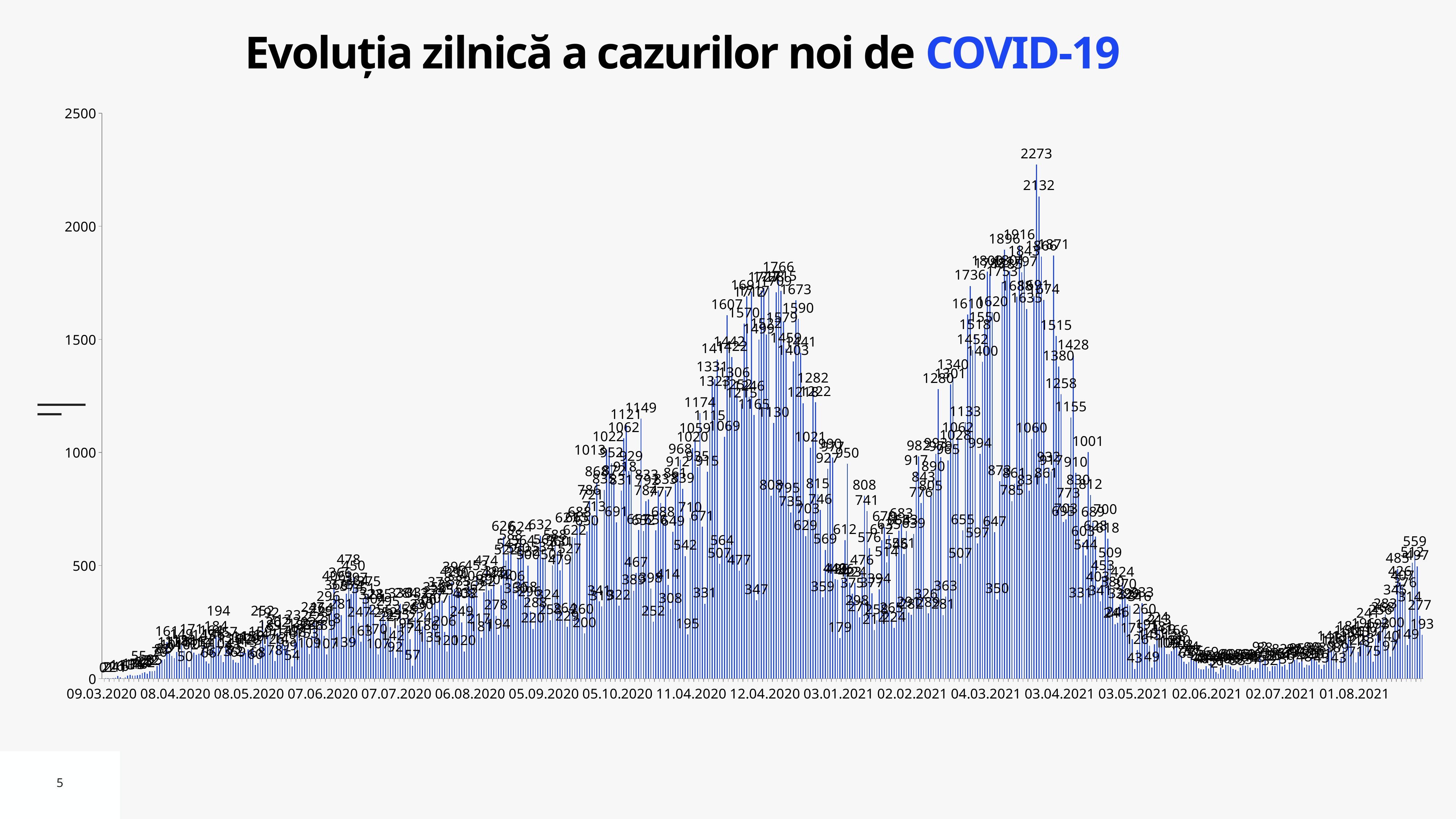
What is the highest daily value labelled on the chart? 2273 Do the values rise or fall from 02.06.2021 to the end of the chart? rise What is the highest tick value on the vertical axis? 2500 Is the value for 02.06.2021 greater or less than 500? less What is the second-highest daily value labelled on the chart, next to the 2273 peak? 2132 Is the value for 09.03.2020 greater or less than 500? less Which is larger, the peak of the wave around 03.04.2021 or the peak of the wave around 12.04.2020? the peak around 03.04.2021 What kind of chart is shown on the slide? bar chart Is the highest value on the chart greater or less than 2000? greater What is the title of the chart? Evoluția zilnică a cazurilor noi de COVID-19